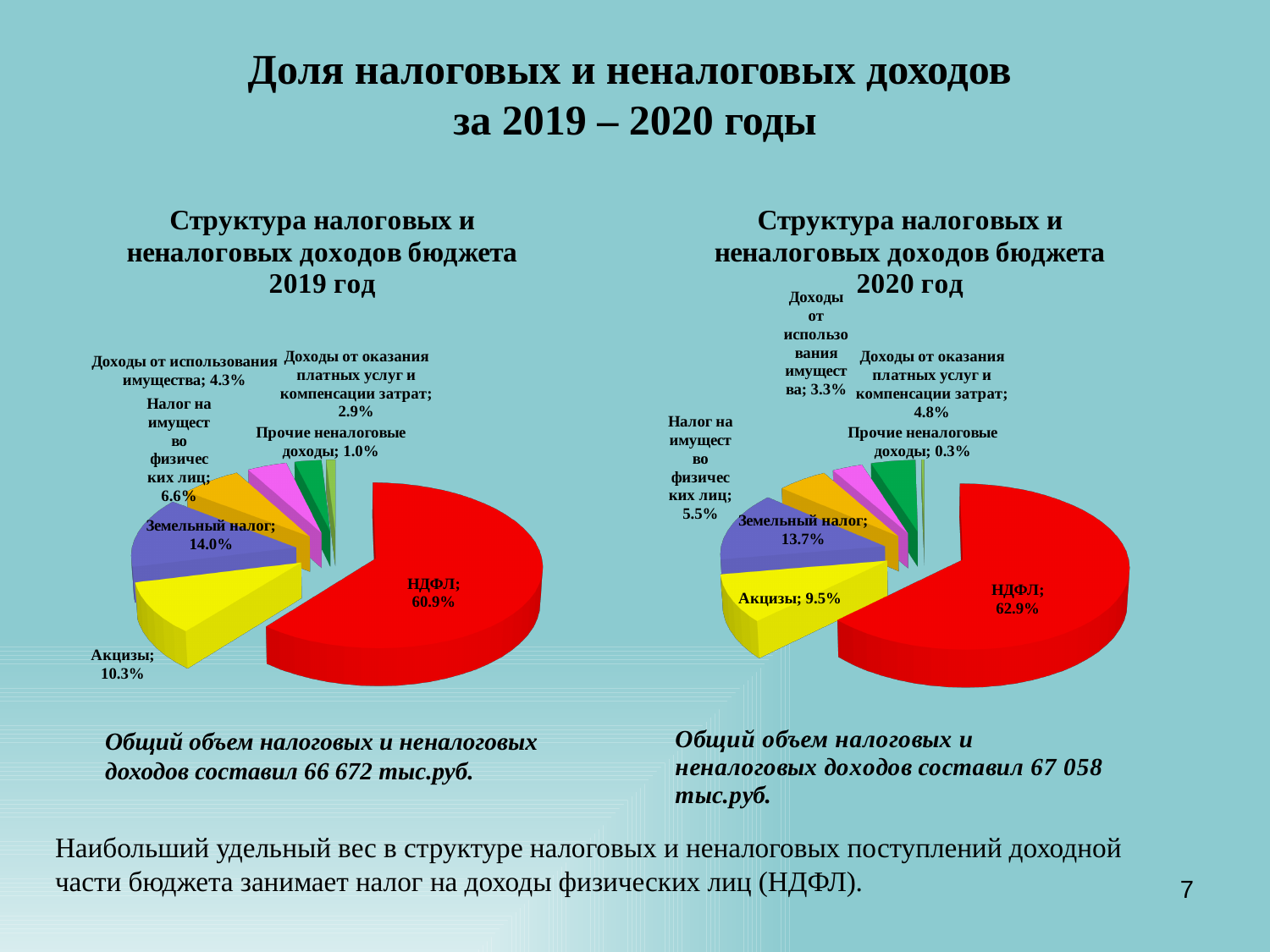
In the 2019 pie chart (left), what share does НДФЛ have? 60.9% In the 2020 pie chart (right), what is the share of Налог на имущество физических лиц? 5.5% Which is larger: the share of Доходы от оказания платных услуг и компенсации затрат in 2019 (left chart) or in 2020 (right chart)? 2020 In the 2020 pie chart (right), what is the share of Земельный налог? 13.7% How many categories are shown in the 2020 pie chart (right)? 7 In the 2020 pie chart (right), what share does НДФЛ have? 62.9% In the 2019 pie chart (left), which category has the largest share? НДФЛ In the 2020 pie chart (right), which category has the smallest share? Прочие неналоговые доходы What type of chart is used on the left for the 2019 structure? Pie chart In the 2019 pie chart (left), what is the share of Акцизы? 10.3% What colour is the НДФЛ slice in both pie charts? Red In the 2019 pie chart (left), what is the difference between the shares of Земельный налог and Акцизы? 3.7%